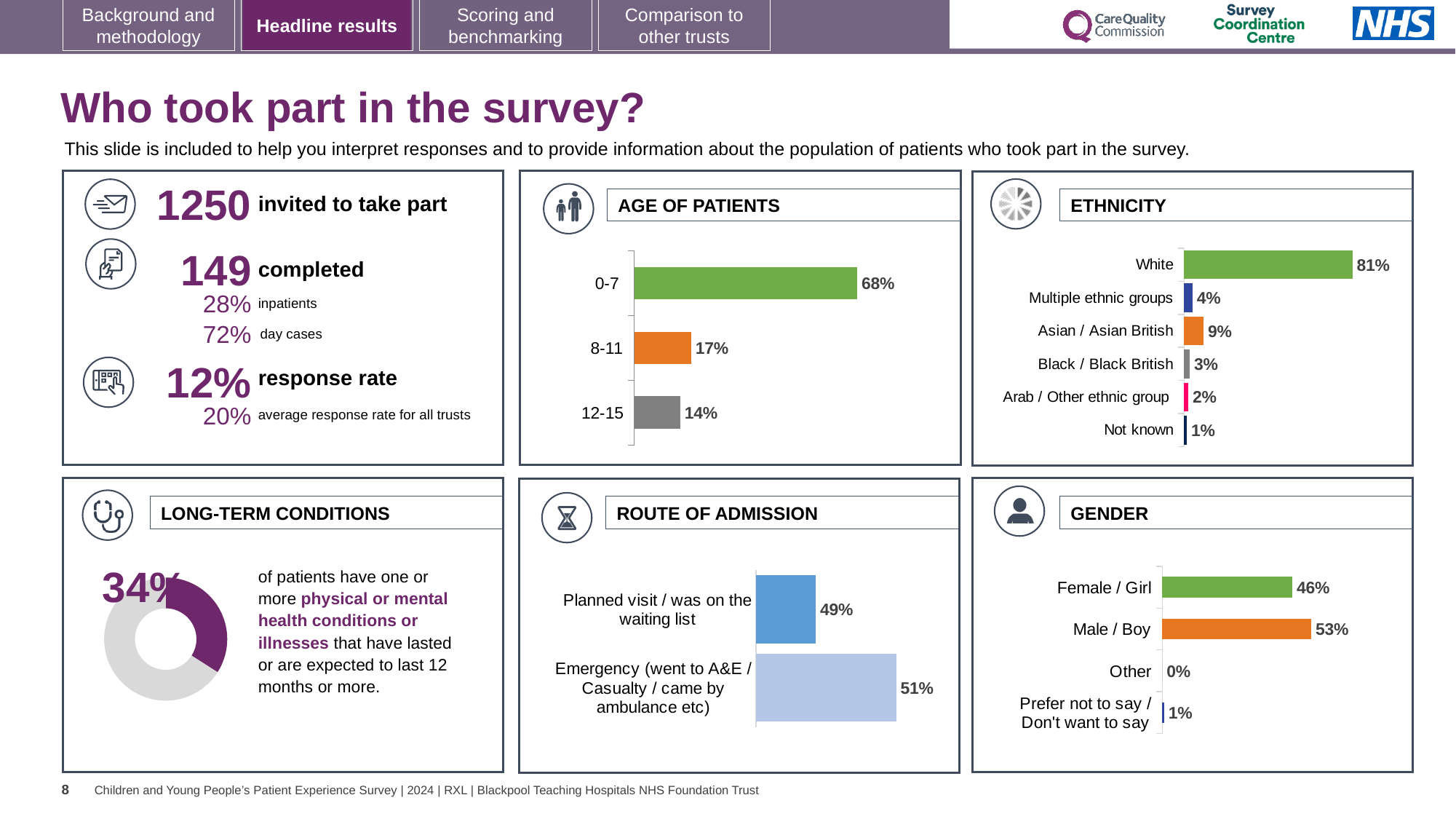
What kind of chart is the ROUTE OF ADMISSION chart? Bar chart In the AGE OF PATIENTS chart, what is the value for the 0-7 age group? 68% In the AGE OF PATIENTS chart, which age group has the lowest value? 12-15 In the ETHNICITY chart, which category has the highest value? White In the ETHNICITY chart, which is larger: Multiple ethnic groups or Black / Black British? Multiple ethnic groups In the GENDER chart, what is the value for Male / Boy? 53% In the GENDER chart, what is the difference between Male / Boy and Female / Girl? 7 percentage points In the AGE OF PATIENTS chart, what is the difference between the 0-7 and 8-11 values? 51 percentage points In the LONG-TERM CONDITIONS donut chart, what share of patients have one or more long-term conditions? 34% In the ROUTE OF ADMISSION chart, what is the value for Emergency (went to A&E / Casualty / came by ambulance etc)? 51% How many categories are shown in the ETHNICITY chart? 6 In the ETHNICITY chart, what is the value for Asian / Asian British? 9%